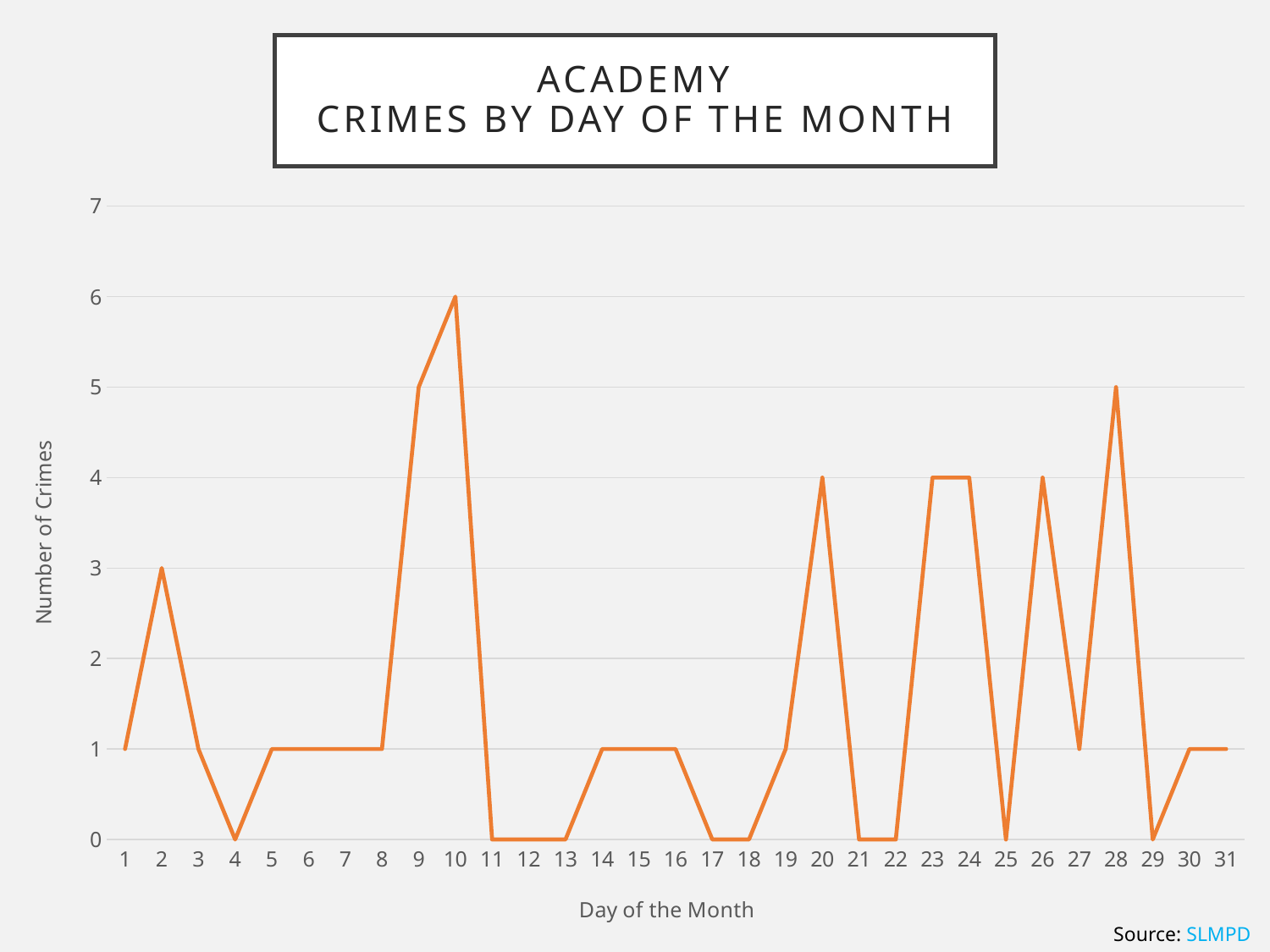
Is the number of crimes on day 9 greater or less than 4? greater What type of chart is shown on the slide? line chart How many days of the month are plotted on the x axis? 31 What is the number of crimes on day 28? 5 What is the number of crimes on day 20? 4 What is the label of the y axis? Number of Crimes Which has more crimes, day 28 or day 26? day 28 What is the number of crimes on day 10? 6 What is the title of the chart? Academy Crimes by Day of the Month What is the number of crimes on day 2? 3 What is the difference in the number of crimes between day 10 and day 9? 1 Which day of the month has the highest number of crimes? 10